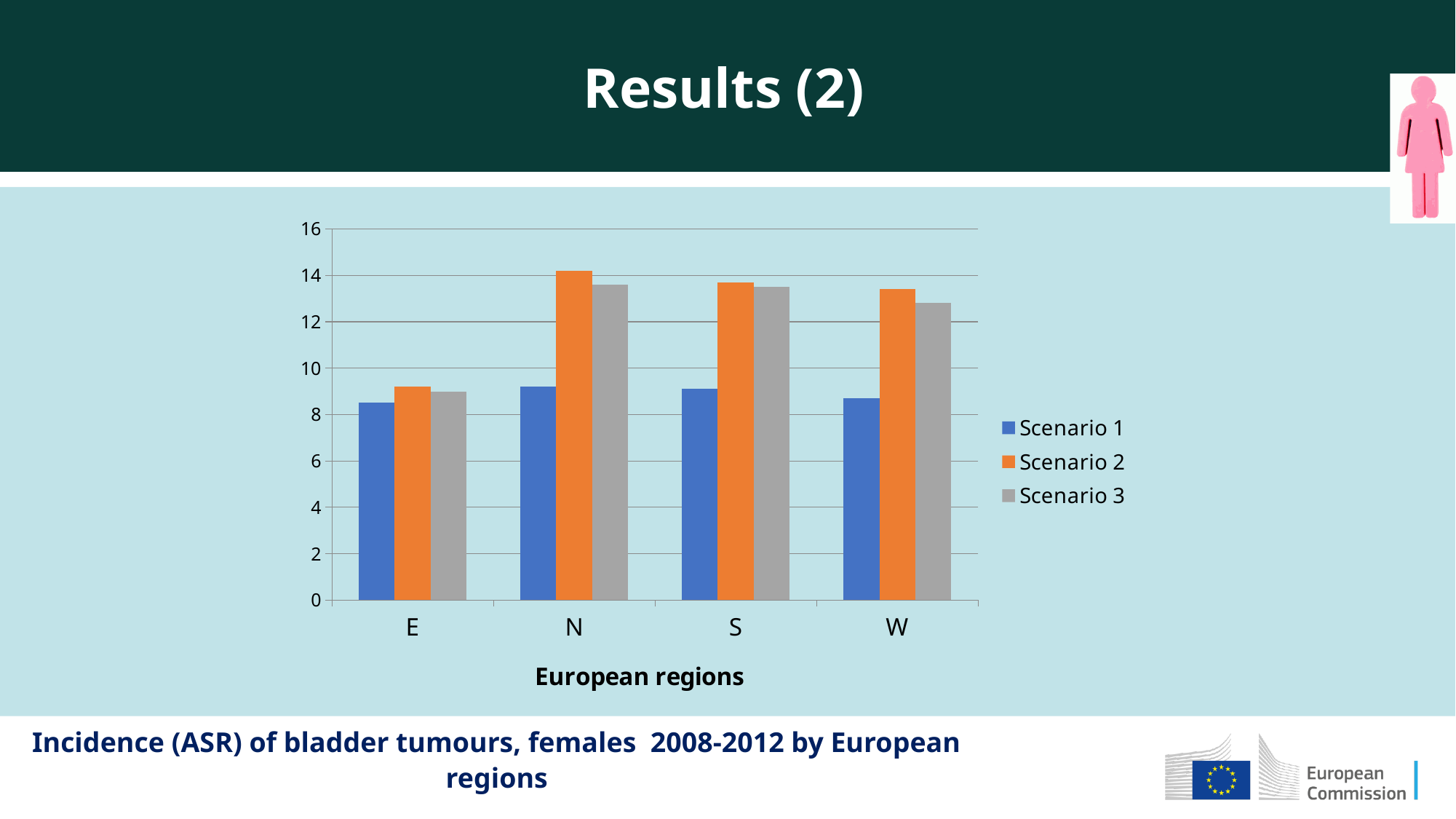
What is the title of the x axis of the chart? European regions How many series does the chart's legend list? 3 Is the Scenario 2 value for E greater or less than 10? less Is the Scenario 1 value for N greater or less than 10? less Is the Scenario 3 value for W greater or less than 12? greater Which is larger: the Scenario 3 value for N or the Scenario 3 value for W? N Which region has the lowest Scenario 3 value? E For region N, which is larger: the Scenario 1 value or the Scenario 2 value? Scenario 2 What kind of chart is shown on the slide? bar chart Which region has the lowest Scenario 2 value? E Which region has the highest Scenario 2 value? N How many European regions are shown on the x axis of the chart? 4